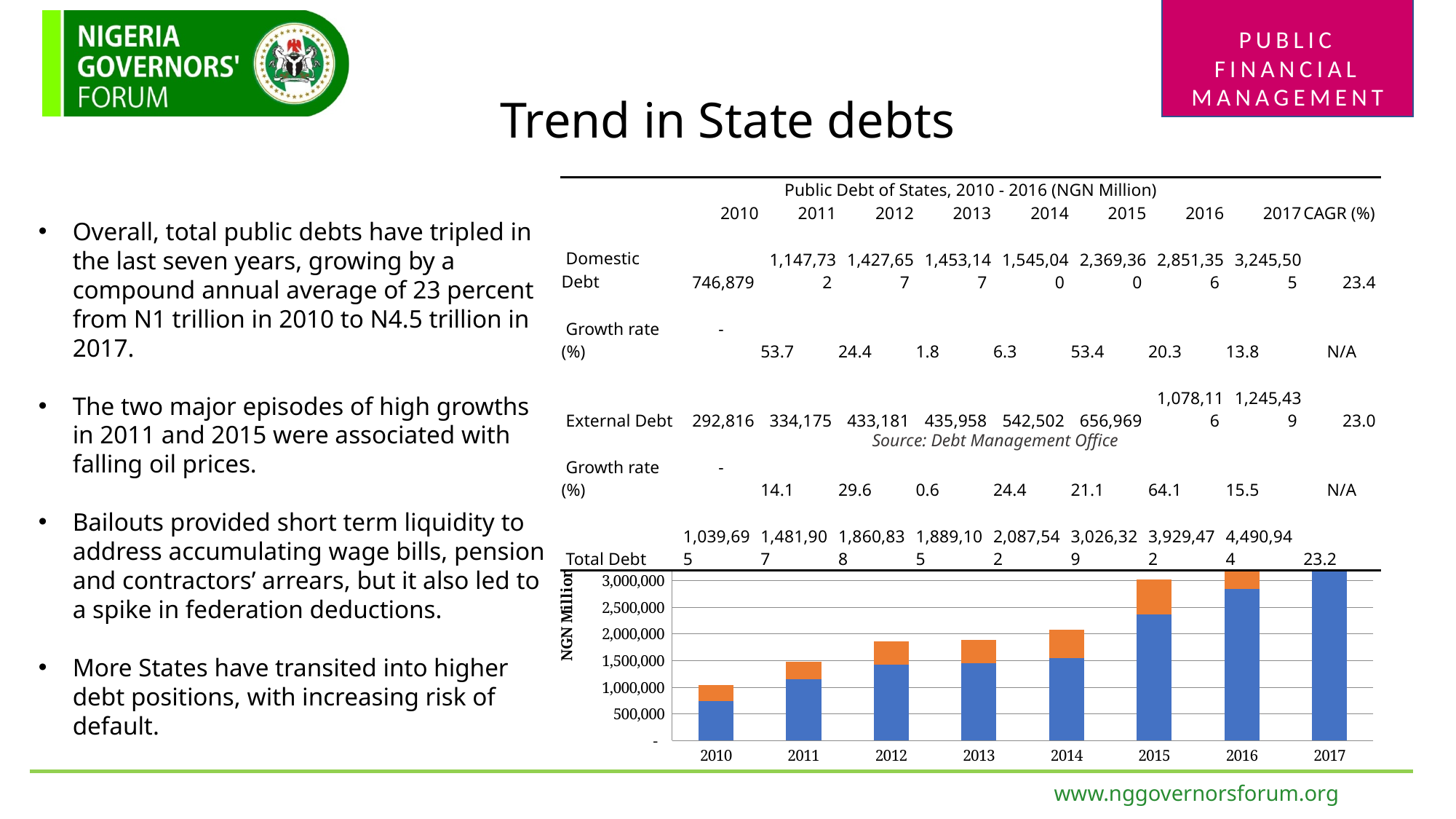
Which year has the tallest bar in the chart? 2017 Is the total bar for 2015 greater or less than 2,500,000? greater Is the blue portion of the 2010 bar greater or less than 500,000? greater Is the total bar for 2015 taller or shorter than the total bar for 2014? Taller What kind of chart is shown at the bottom right of the slide? Stacked bar chart Is the blue portion of the 2015 bar greater or less than 2,000,000? greater How many years are shown on the x axis of the bar chart? 8 What is the label on the vertical axis of the bar chart? NGN Million Which year has the shortest bar in the chart? 2010 Do the bar heights generally rise or fall from 2010 to 2017? Rise